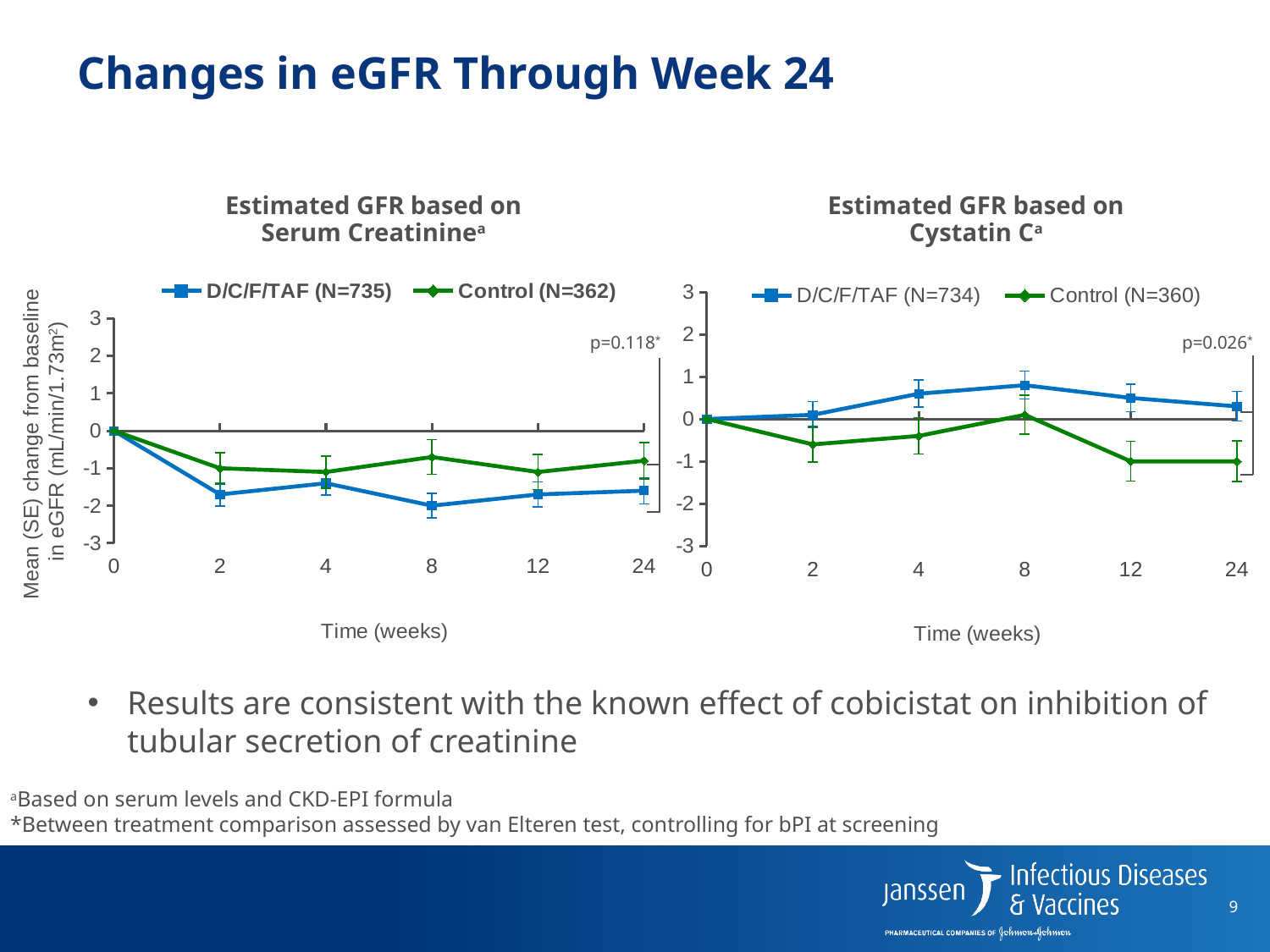
In the 'Estimated GFR based on Serum Creatinine' chart, does the D/C/F/TAF line rise or fall from week 0 to week 2? fall In the 'Estimated GFR based on Serum Creatinine' chart, what N is given for the Control group in the legend? 362 In the 'Estimated GFR based on Serum Creatinine' chart, which series has the higher value at week 8? Control (N=362) In the 'Estimated GFR based on Cystatin C' chart, is the value for Control at week 12 greater or less than 0? less In the 'Estimated GFR based on Cystatin C' chart, is the value for D/C/F/TAF at week 8 greater or less than 0? greater In the 'Estimated GFR based on Serum Creatinine' chart, how many series does the legend list? 2 What kind of chart is the 'Estimated GFR based on Serum Creatinine' chart? line chart In the 'Estimated GFR based on Cystatin C' chart, which series has the higher value at week 24? D/C/F/TAF (N=734) In the 'Estimated GFR based on Serum Creatinine' chart, is the value for D/C/F/TAF at week 8 greater or less than -1? less In the 'Estimated GFR based on Cystatin C' chart, how many time points are plotted on the x axis? 6 What p-value is shown on the 'Estimated GFR based on Cystatin C' chart? p=0.026